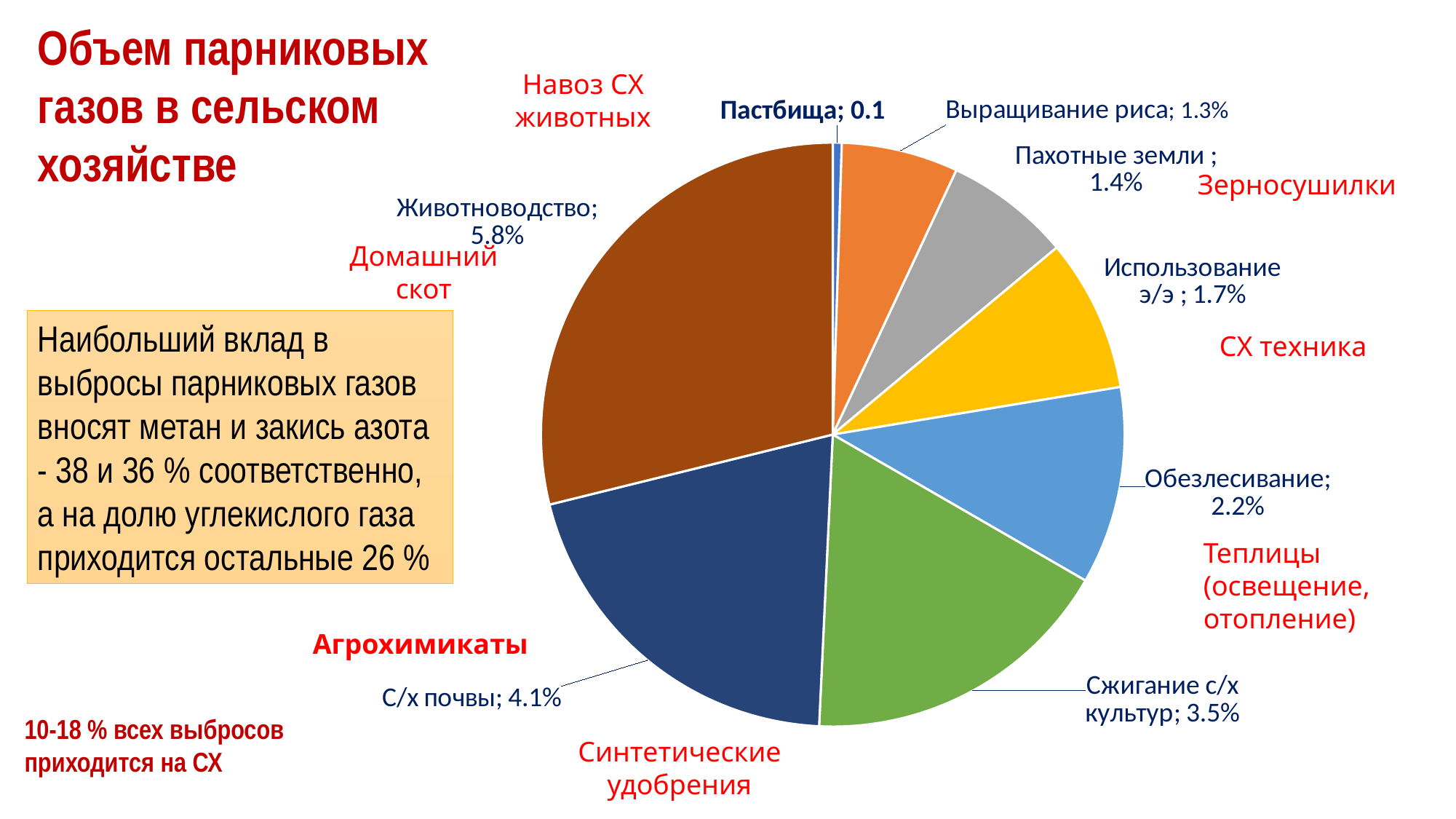
Which category has the smallest slice of the pie? Пастбища What is the value for Пастбища? 0.1 What is the value for С/х почвы? 4.1% Which is larger, the value for Обезлесивание or the value for Использование э/э? Обезлесивание What is the value for Животноводство? 5.8% How many slices does the pie chart have? 8 What is the value for Сжигание с/х культур? 3.5% What is the difference between the values for Пахотные земли and Выращивание риса? 0.1% What is the difference between the values for Животноводство and С/х почвы? 1.7% What is the value for Обезлесивание? 2.2% Which category has the largest slice of the pie? Животноводство What kind of chart is shown on the slide? pie chart